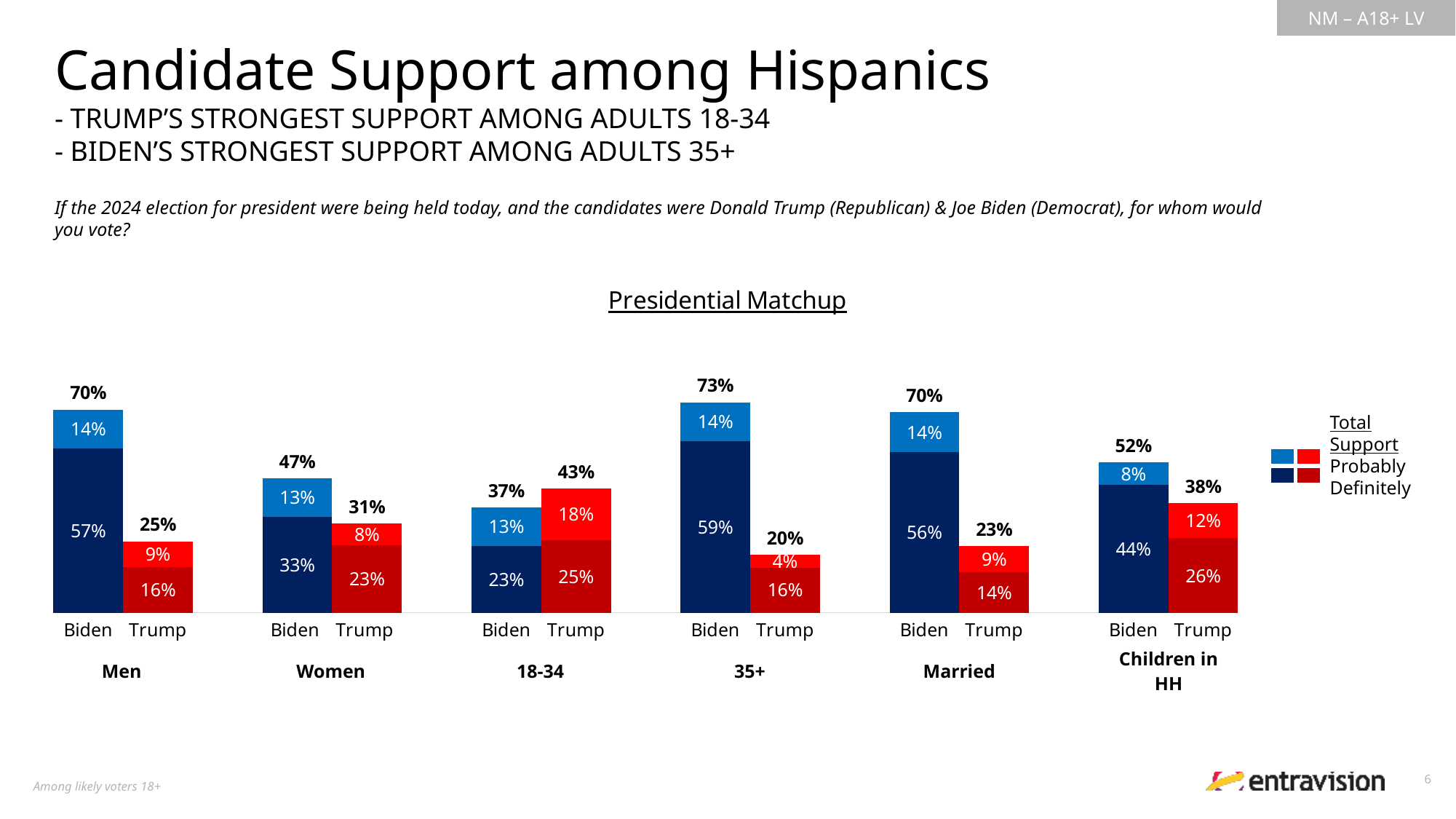
What is the difference between Biden's and Trump's total support among Married respondents? 47% Among adults 18-34, who has higher total support, Biden or Trump? Trump What is the total support for Biden among Men? 70% What two levels of support does the legend distinguish? Probably and Definitely What is the title of the chart? Presidential Matchup What is the 'Probably' share for Biden among Women? 13% What is the 'Definitely' share for Trump among adults 18-34? 25% In which demographic group is Biden's total support highest? 35+ How many demographic groups are shown on the chart? 6 What kind of chart is shown on the slide? Stacked bar chart What is the total support for Trump among households with Children in HH? 38% In which demographic group is Trump's total support lowest? 35+